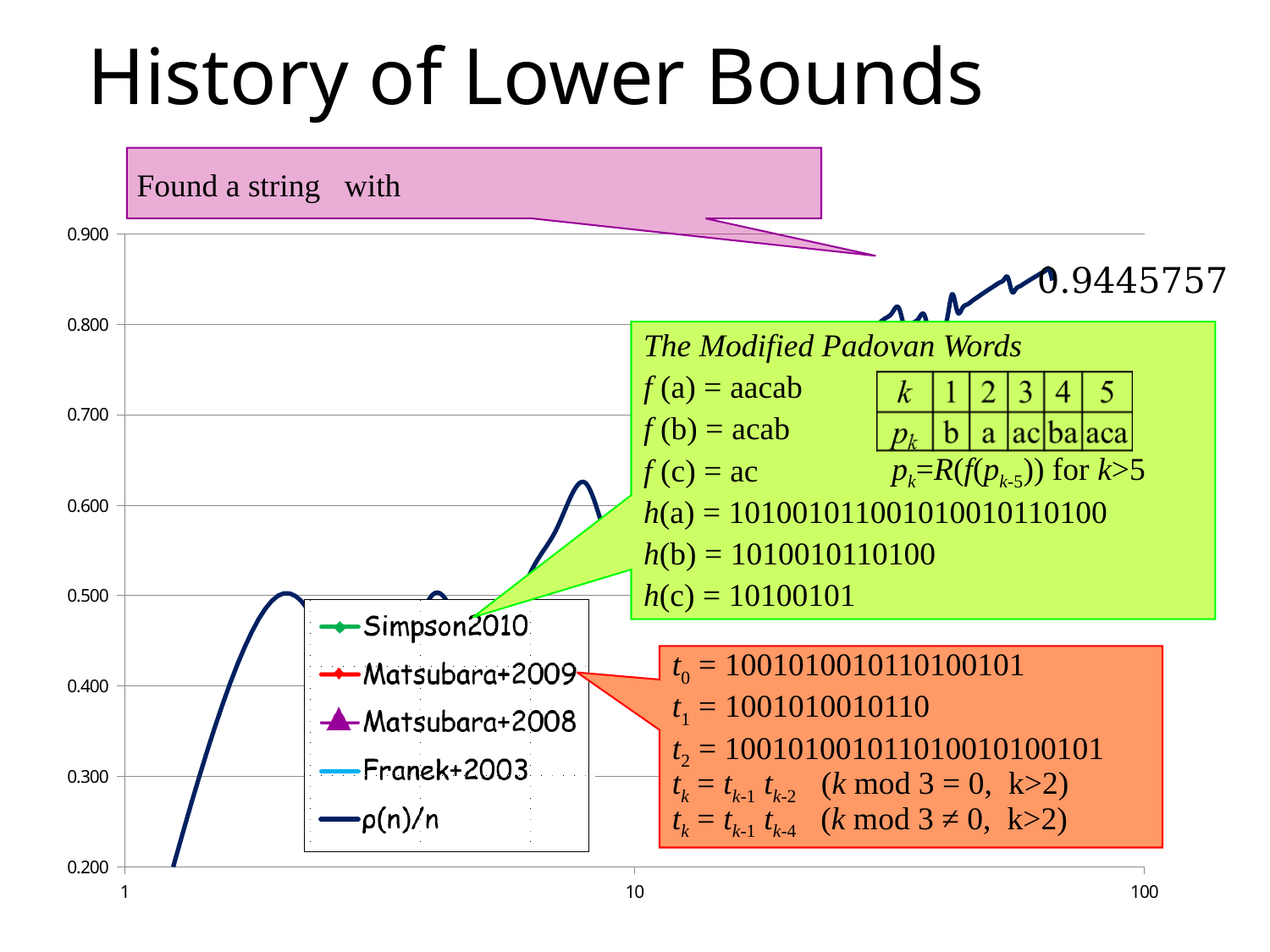
Is the peak of the ρ(n)/n curve just below x = 10 greater or less than 0.500? greater Is the highest point reached by the ρ(n)/n curve greater or less than 0.800? greater What is the title of the slide containing the chart? History of Lower Bounds Which series are listed in the chart legend? Simpson2010, Matsubara+2009, Matsubara+2008, Franek+2003, ρ(n)/n Does the ρ(n)/n curve generally rise or fall as x increases from 1 toward 100? rise How many series does the chart legend list? 5 Is the first peak of the ρ(n)/n curve (between x = 1 and x = 10) greater or less than 0.600? less What kind of chart is shown on the slide? line chart